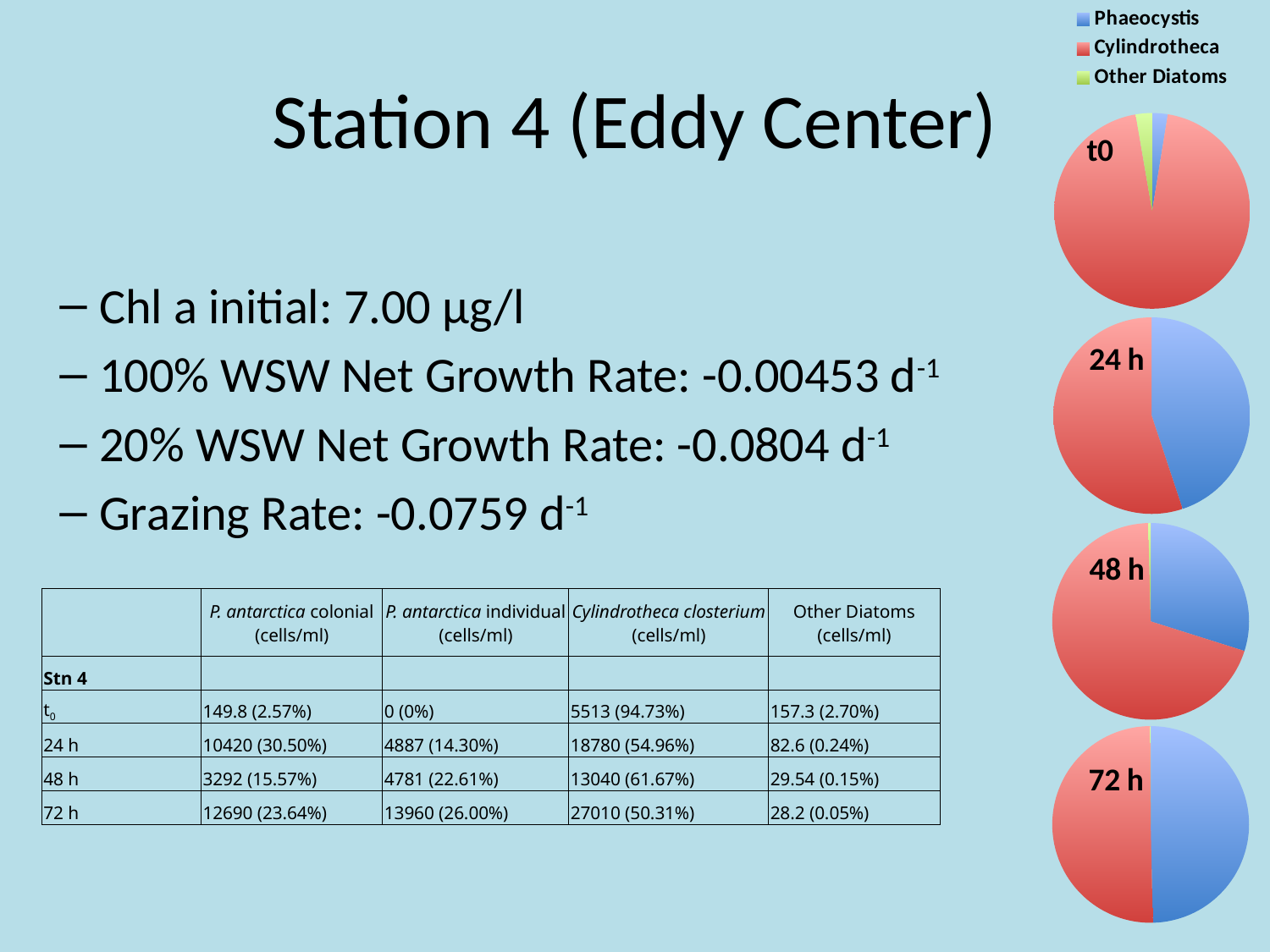
In the 48 h pie chart, which category has the largest slice? Cylindrotheca What are the labels of the four pie charts, from top to bottom? t0, 24 h, 48 h, 72 h How many series does the legend at the top right of the slide list? 3 How many pie charts are shown on the slide? 4 In the 24 h pie chart, is the Cylindrotheca slice larger or smaller than the Phaeocystis slice? larger In the 48 h pie chart, is the Phaeocystis slice larger or smaller than the Cylindrotheca slice? smaller In the 48 h pie chart, which category has the smallest slice? Other Diatoms What kind of chart is used for the t0 chart on the right of the slide? pie chart Across the pie charts from t0 to 48 h, does the Phaeocystis slice grow or shrink between t0 and 24 h? grow Which colour represents Phaeocystis in the pie charts? blue In the t0 pie chart, which category has the largest slice? Cylindrotheca In the t0 pie chart, is the Cylindrotheca slice larger or smaller than the Phaeocystis slice? larger